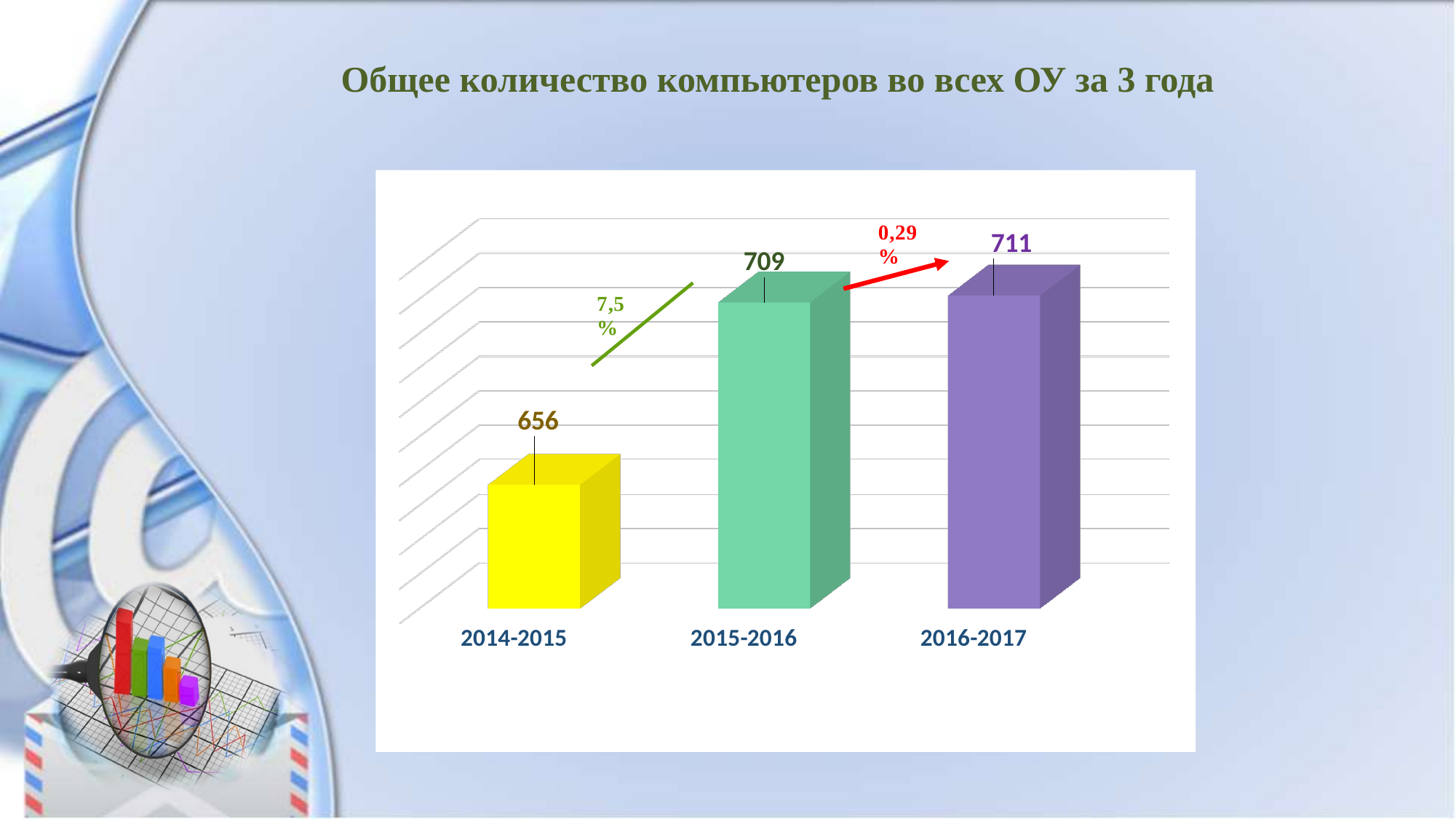
What is the value for 2016-2017? 711 What is the difference between the values for 2015-2016 and 2014-2015? 53 Which period has the highest value? 2016-2017 What is the value for 2015-2016? 709 What is the difference between the values for 2016-2017 and 2015-2016? 2 Which is larger, the value for 2014-2015 or the value for 2015-2016? 2015-2016 How many periods are shown on the x axis? 3 Which period has the lowest value? 2014-2015 Do the values rise or fall from 2014-2015 to 2016-2017? rise What is the value for 2014-2015? 656 What percentage change is annotated between 2014-2015 and 2015-2016? 7,5 % What kind of chart is shown on the slide? bar chart